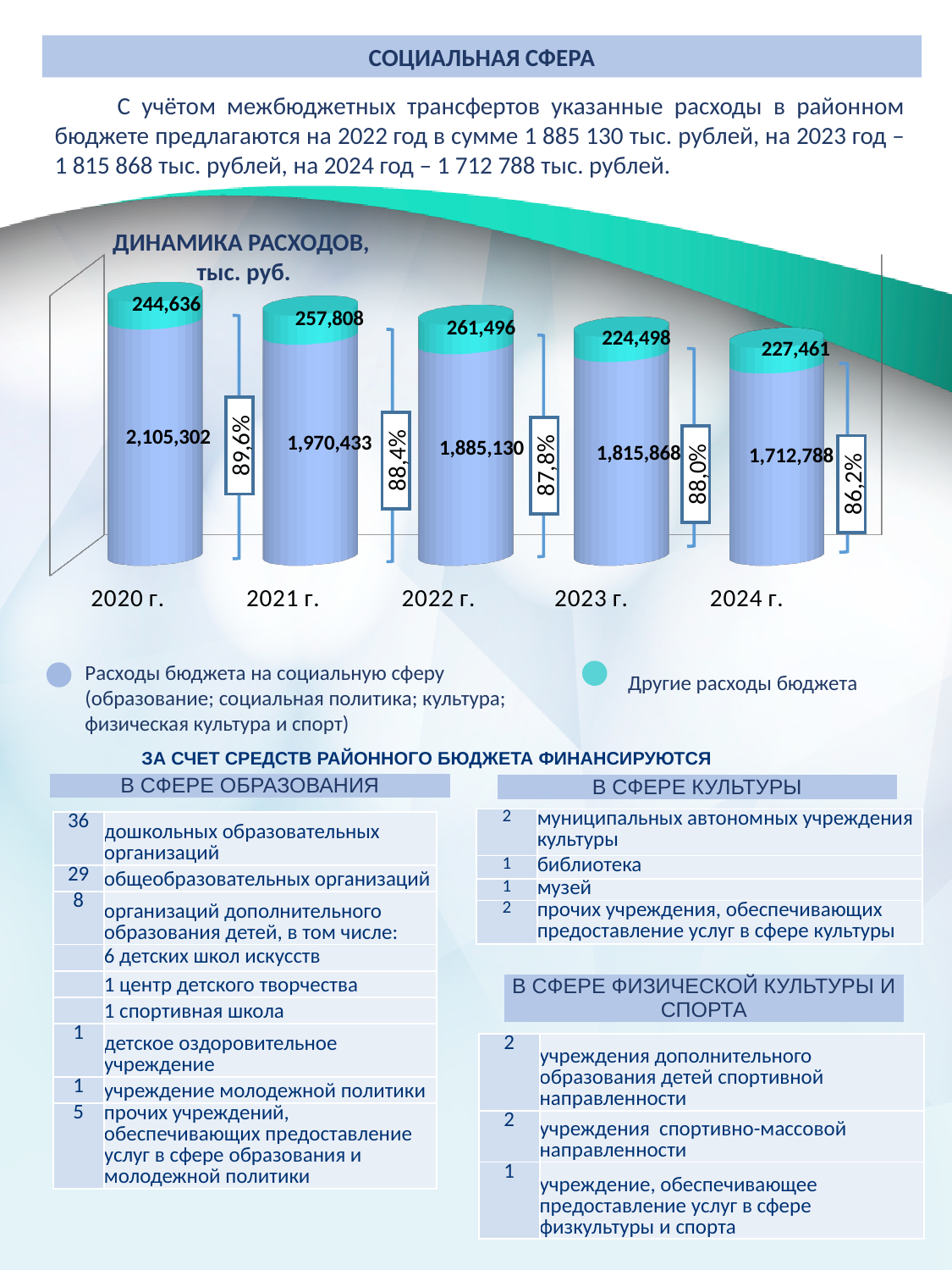
How many series does the chart legend list? 2 What is the value of other budget expenses (Другие расходы бюджета) for 2022 г.? 261,496 What is the value of social sphere budget expenses (Расходы бюджета на социальную сферу) for 2020 г.? 2,105,302 What is the total of the stacked bar for 2022 г.? 2,146,626 Which year has the lowest value of other budget expenses? 2023 г. What kind of chart is used to show the dynamics of expenses? Stacked bar chart Do the social sphere budget expenses rise or fall from 2020 г. to 2024 г.? Fall What is the value of social sphere budget expenses for 2024 г.? 1,712,788 How many years are shown on the x axis of the chart? 5 Which is larger: other budget expenses in 2021 г. or in 2024 г.? 2021 г. Which year has the highest value of social sphere budget expenses? 2020 г. What is the difference between social sphere budget expenses in 2020 г. and 2024 г.? 392,514